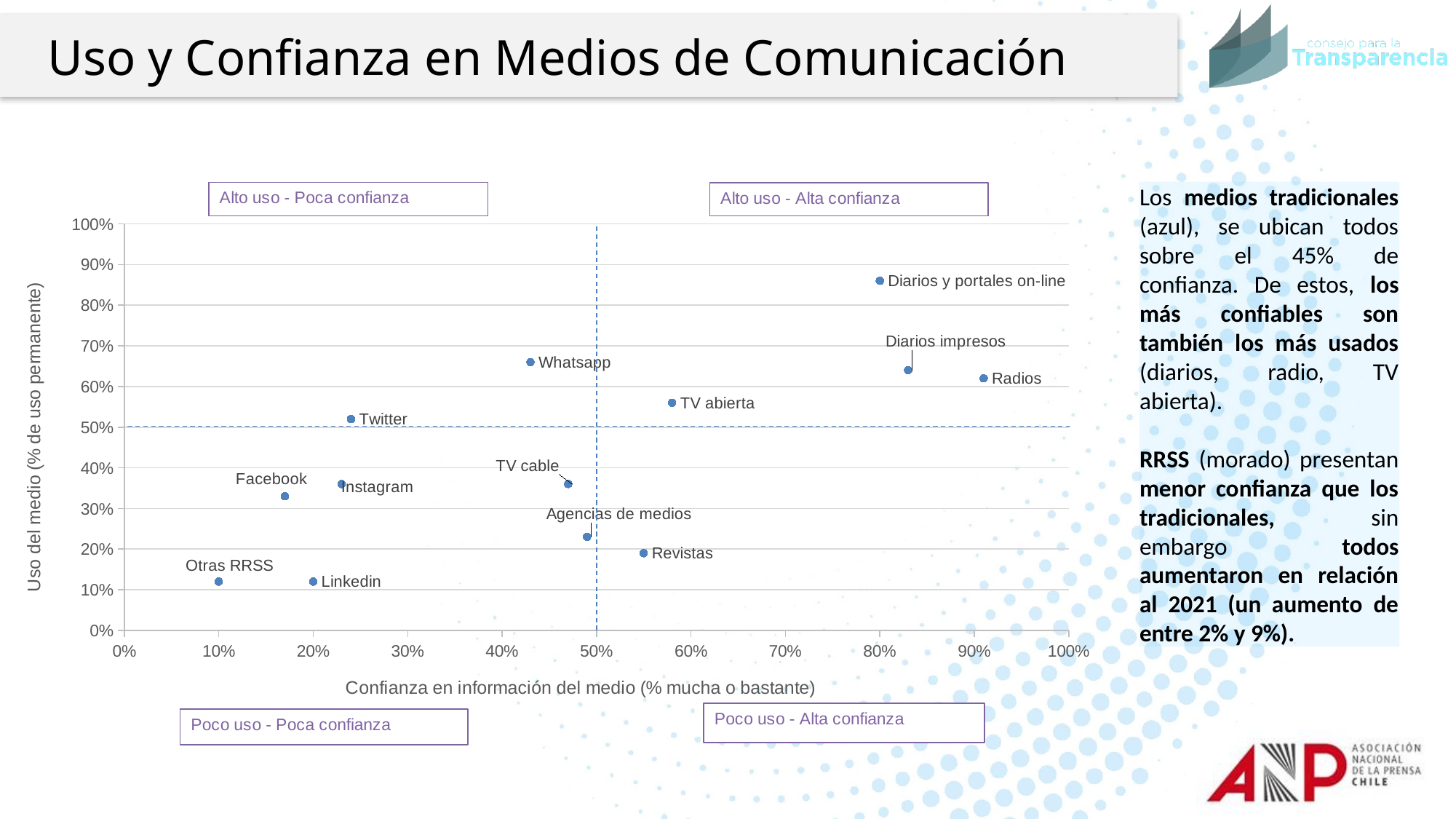
What kind of chart is shown on the slide? scatter chart Which medium has the highest value on the horizontal axis (Confianza en información del medio)? Radios Which has a higher confidence value (horizontal axis), Radios or Diarios impresos? Radios Is the use value (vertical axis) for Diarios y portales on-line greater or less than 80%? greater Is the confidence value (horizontal axis) for Radios greater or less than 80%? greater Is the use value (vertical axis) for Whatsapp greater or less than 60%? greater Which medium has the lowest value on the horizontal axis (Confianza en información del medio)? Otras RRSS How many media points are plotted on the chart? 13 What is the title of the horizontal axis of the chart? Confianza en información del medio (% mucha o bastante) Which medium has the highest value on the vertical axis (Uso del medio)? Diarios y portales on-line Which has a higher use value (vertical axis), Whatsapp or TV abierta? Whatsapp